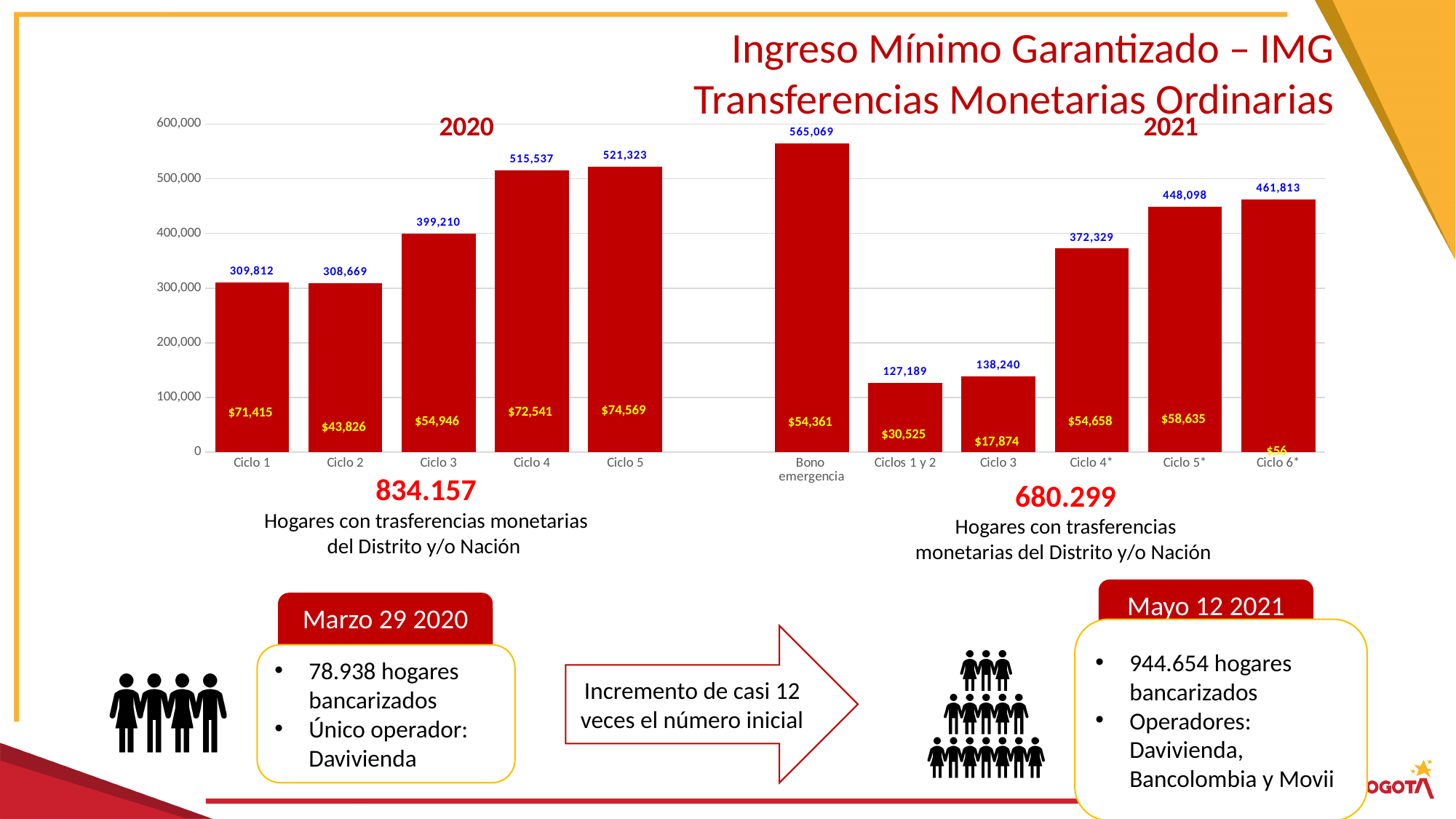
What is the value shown above the bar for Ciclo 4 in 2020? 515,537 What is the yellow dollar label inside the bar for Ciclo 6* in 2021? $56 Which category has the highest bar in the chart? Bono emergencia What is the yellow dollar label inside the bar for Ciclo 5 in 2020? $74,569 How many bars are plotted in the chart? 11 What kind of chart is shown on the slide? bar chart Which category has the lowest bar in the chart? Ciclos 1 y 2 Is the value for Ciclo 4* in 2021 greater or less than 400,000? less What is the value shown above the bar for Bono emergencia? 565,069 What is the value shown above the bar for Ciclos 1 y 2 in 2021? 127,189 What is the difference between the values for Ciclo 6* and Ciclo 5* in 2021? 13,715 Which is larger, the value for Ciclo 5 in 2020 or the value for Ciclo 6* in 2021? Ciclo 5 in 2020